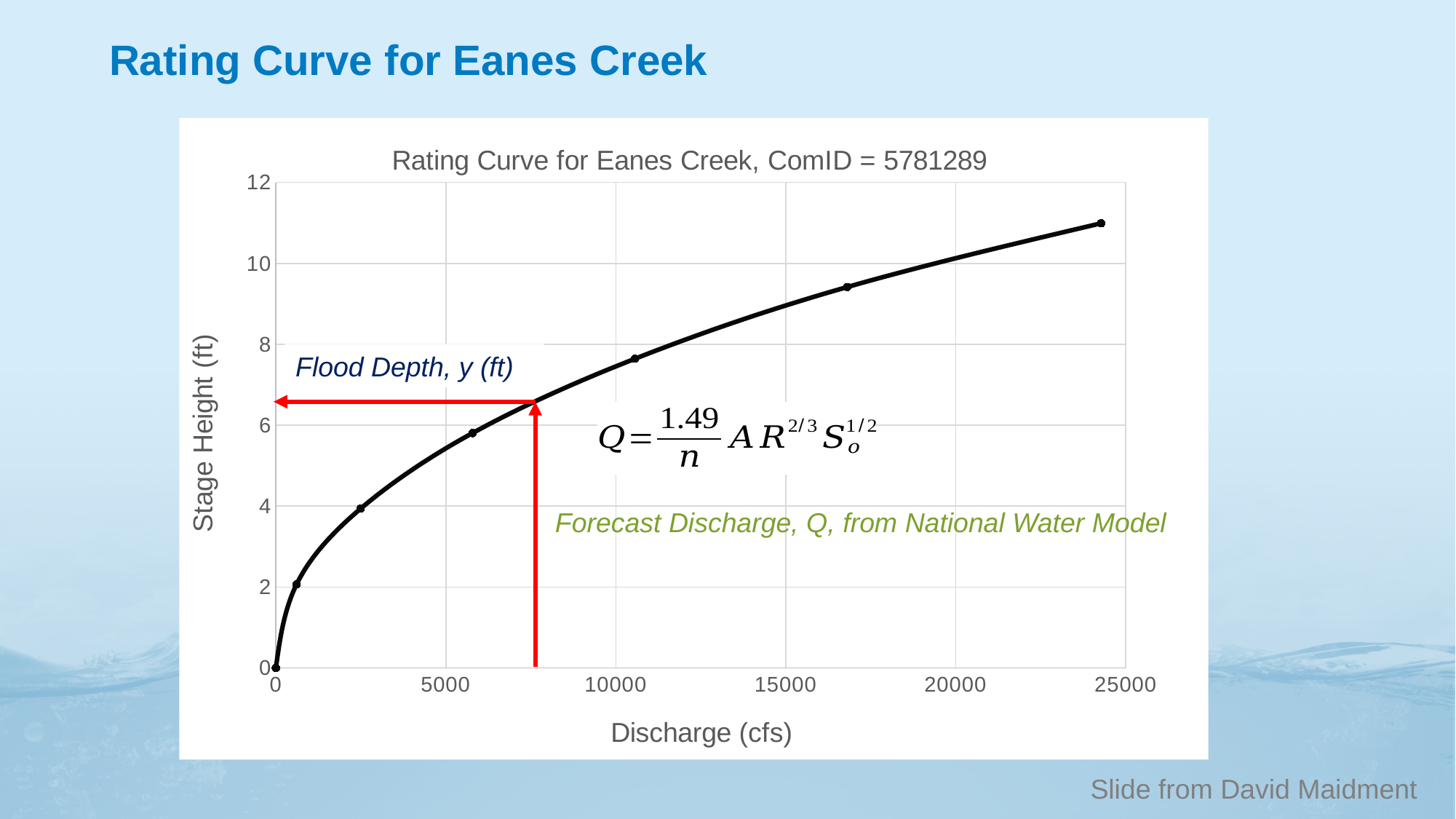
Is the stage height at a discharge of 5000 cfs greater or less than 6 ft? less What kind of chart is shown on the slide? line chart What is the stage height at a discharge of 0 cfs? 0 Is the stage height at a discharge of 15000 cfs greater or less than 8 ft? greater How many data points are marked on the curve? 7 Which has the higher stage height: a discharge of 5000 cfs or a discharge of 20000 cfs? 20000 cfs What is the label of the y axis? Stage Height (ft) Is the stage height at a discharge of 10000 cfs greater or less than 8 ft? less What is the highest value shown on the x axis? 25000 Does the stage height rise or fall as discharge increases along the x axis? rise What is the title of the chart? Rating Curve for Eanes Creek, ComID = 5781289